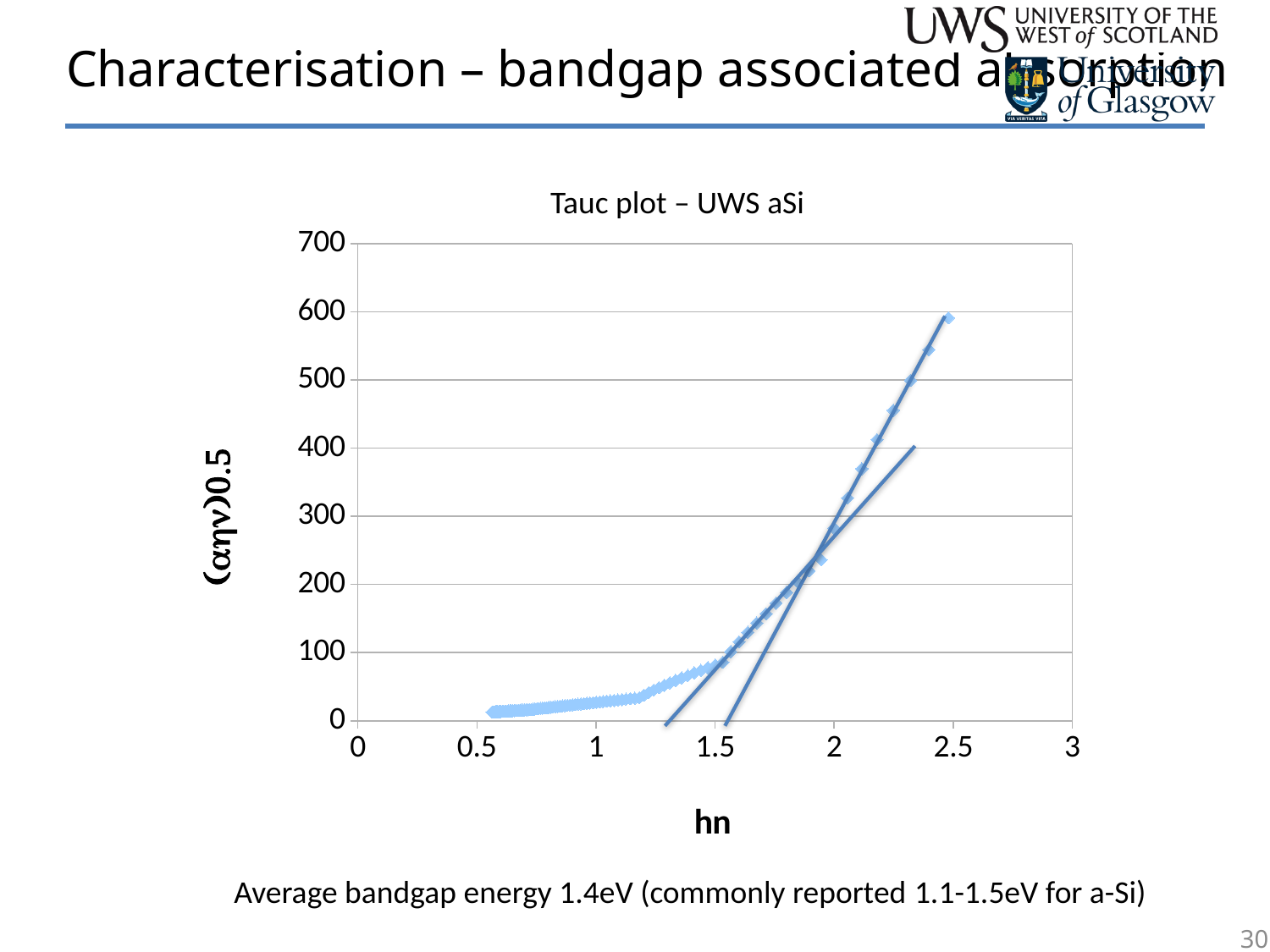
Is the plotted value at hn = 0.6 greater or less than 100? less Is the highest plotted value on the chart greater or less than 500? greater Is the plotted value at hn = 2.5 greater or less than 400? greater Does the highest plotted value occur at the low or high end of the hn range? High end Which is larger: the plotted value at hn = 2 or the plotted value at hn = 1? hn = 2 Do the plotted values rise or fall as hn increases along the x axis? Rise What is the label on the x axis of the chart? hn What is the title of the chart? Tauc plot – UWS aSi What kind of chart is shown on the slide? Scatter plot